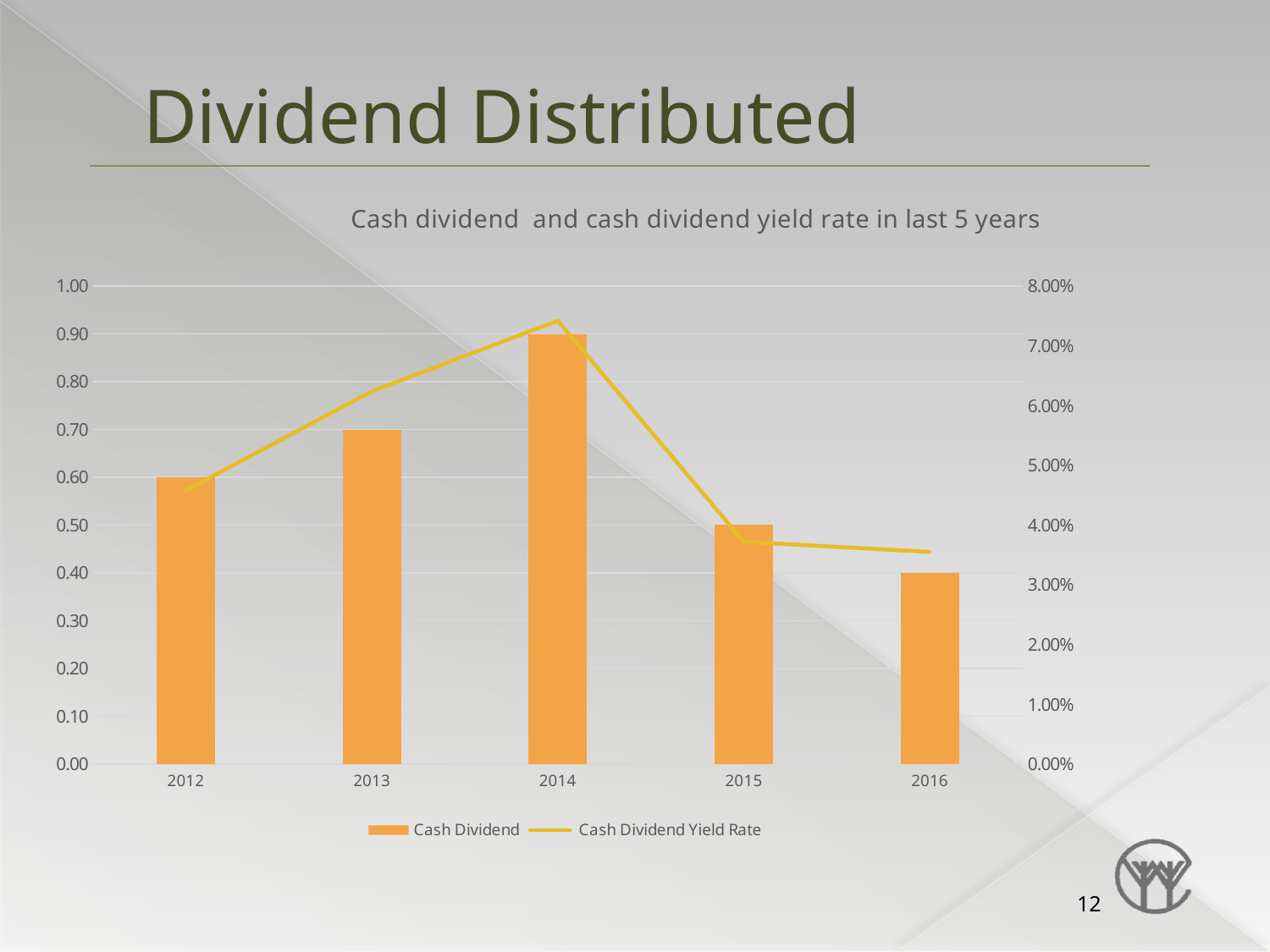
What is the Cash Dividend value for 2016? 0.40 What is the difference between the Cash Dividend in 2014 and in 2016? 0.50 Which year has the lowest Cash Dividend? 2016 Is the Cash Dividend Yield Rate for 2014 greater or less than 7.00%? greater Which year has the highest Cash Dividend? 2014 Does the Cash Dividend rise or fall from 2014 to 2016? fall How many series does the chart legend list? 2 Is the Cash Dividend Yield Rate for 2012 greater or less than 5.00%? less Which year has the larger Cash Dividend, 2013 or 2015? 2013 What is the Cash Dividend value for 2014? 0.90 How many years are shown on the x axis of the chart? 5 What kind of chart is shown on the slide? Combined bar and line chart